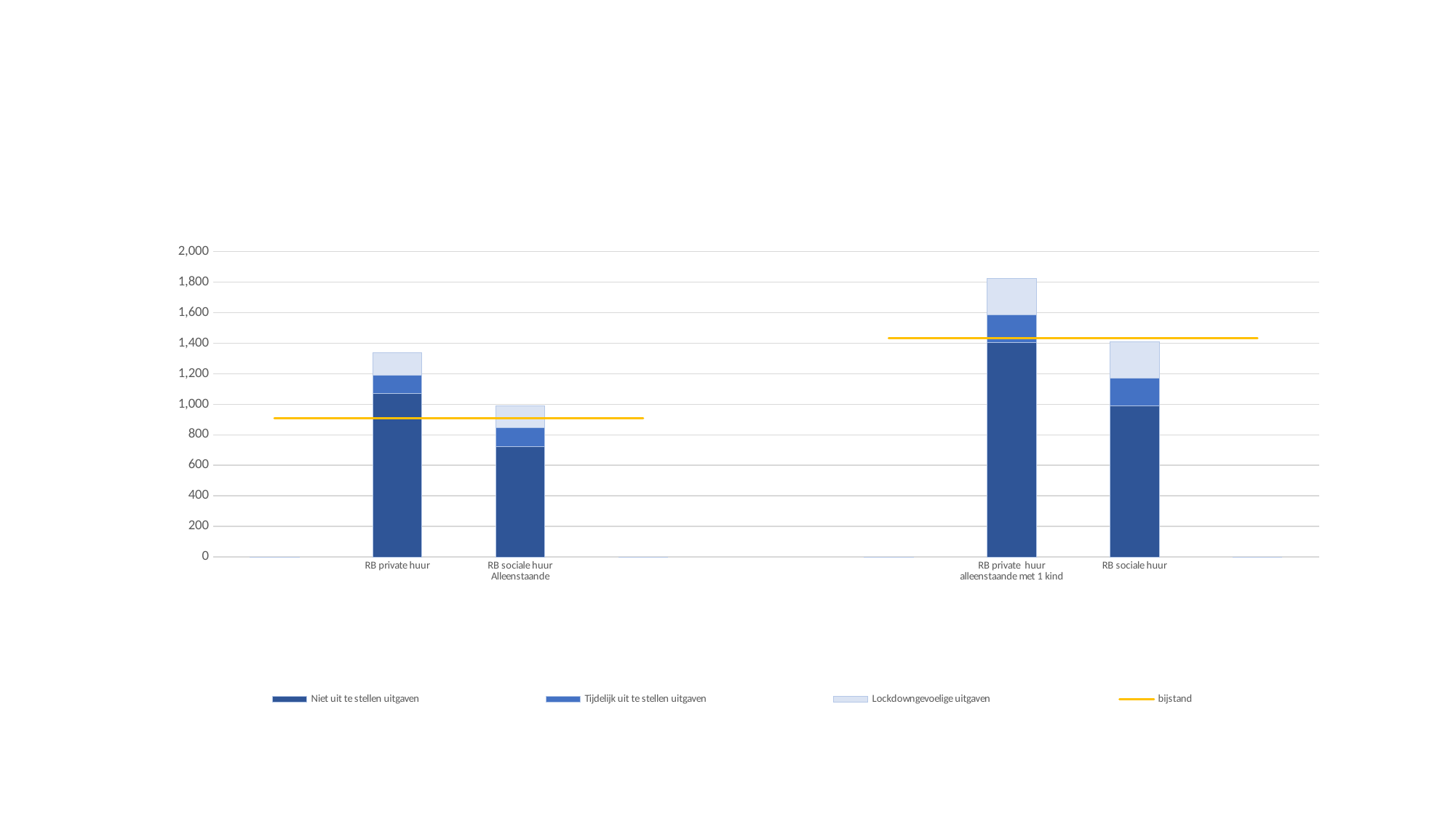
Which bar has the highest total? RB private huur (alleenstaande met 1 kind) Is the bijstand line for the left (Alleenstaande) group greater or less than 1,000? less Is the total of the RB sociale huur bar in the left (Alleenstaande) group greater or less than 1,200? less Which bar has the lowest total? RB sociale huur (Alleenstaande) Is the total of the RB private huur bar in the left (Alleenstaande) group greater or less than 1,200? greater How many entries does the legend list? 4 How many stacked bars are plotted in the chart? 4 What kind of chart is shown on the slide? stacked bar chart Which is larger: the total of the RB private huur bar in the left group or the total of the RB sociale huur bar in the right group? RB sociale huur bar in the right group Which legend entry is drawn as a line rather than a bar segment? bijstand